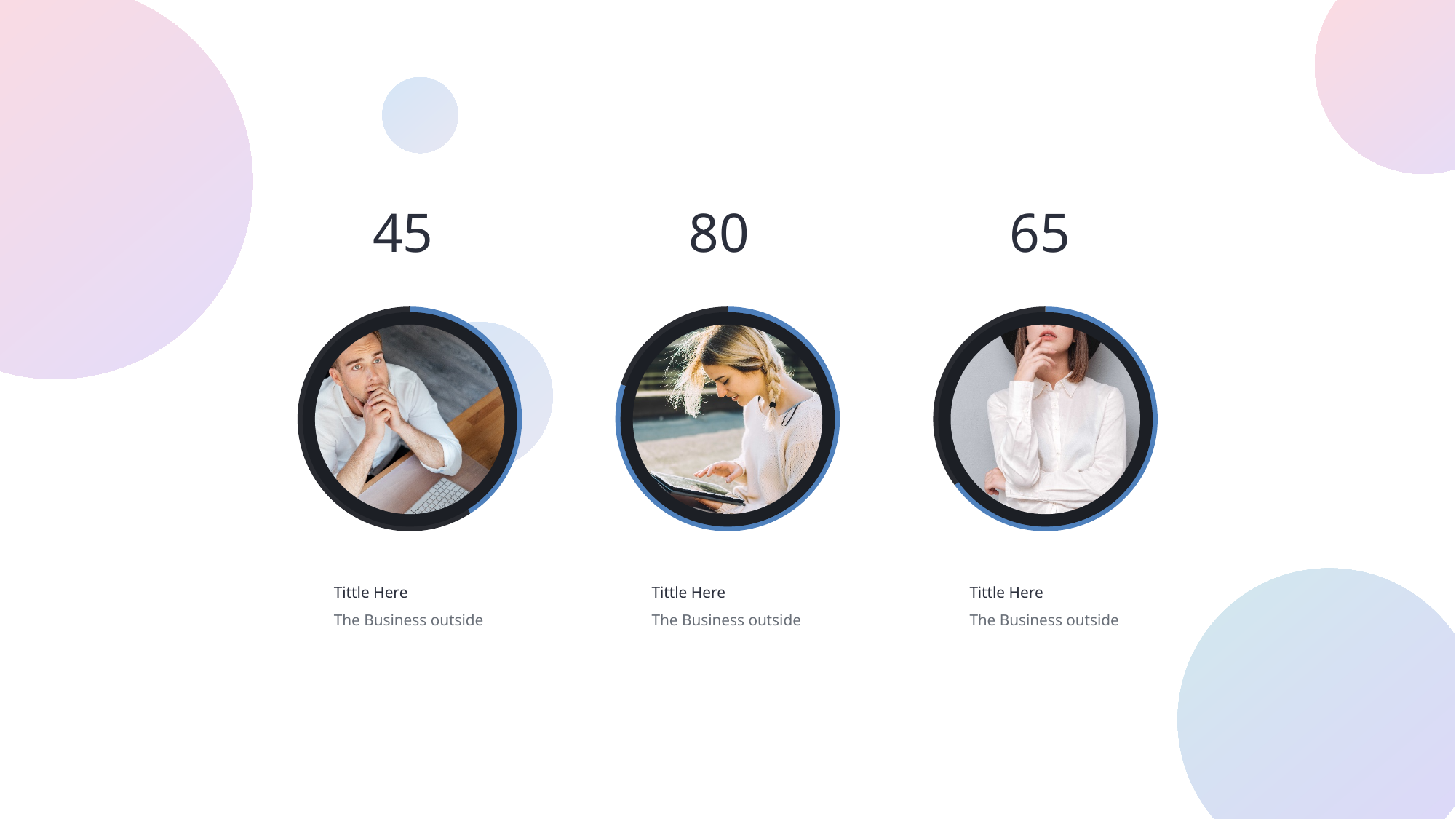
Which of the three circular charts has the highest value? The middle one (80) What value is shown above the right circular chart? 65 What is the difference between the value of the middle chart and the value of the left chart? 35 What value is shown above the middle circular chart? 80 What kind of chart is used to display each value on the slide? Doughnut (ring) chart Which of the three circular charts has the lowest value? The left one (45) What is the difference between the value of the right chart and the value of the left chart? 20 What value is shown above the left circular chart? 45 What colour is the filled portion of the ring in each circular chart? Blue How many circular progress charts are on the slide? 3 What is the difference between the value of the middle chart and the value of the right chart? 15 Is the value of the right chart larger or smaller than the value of the middle chart? smaller